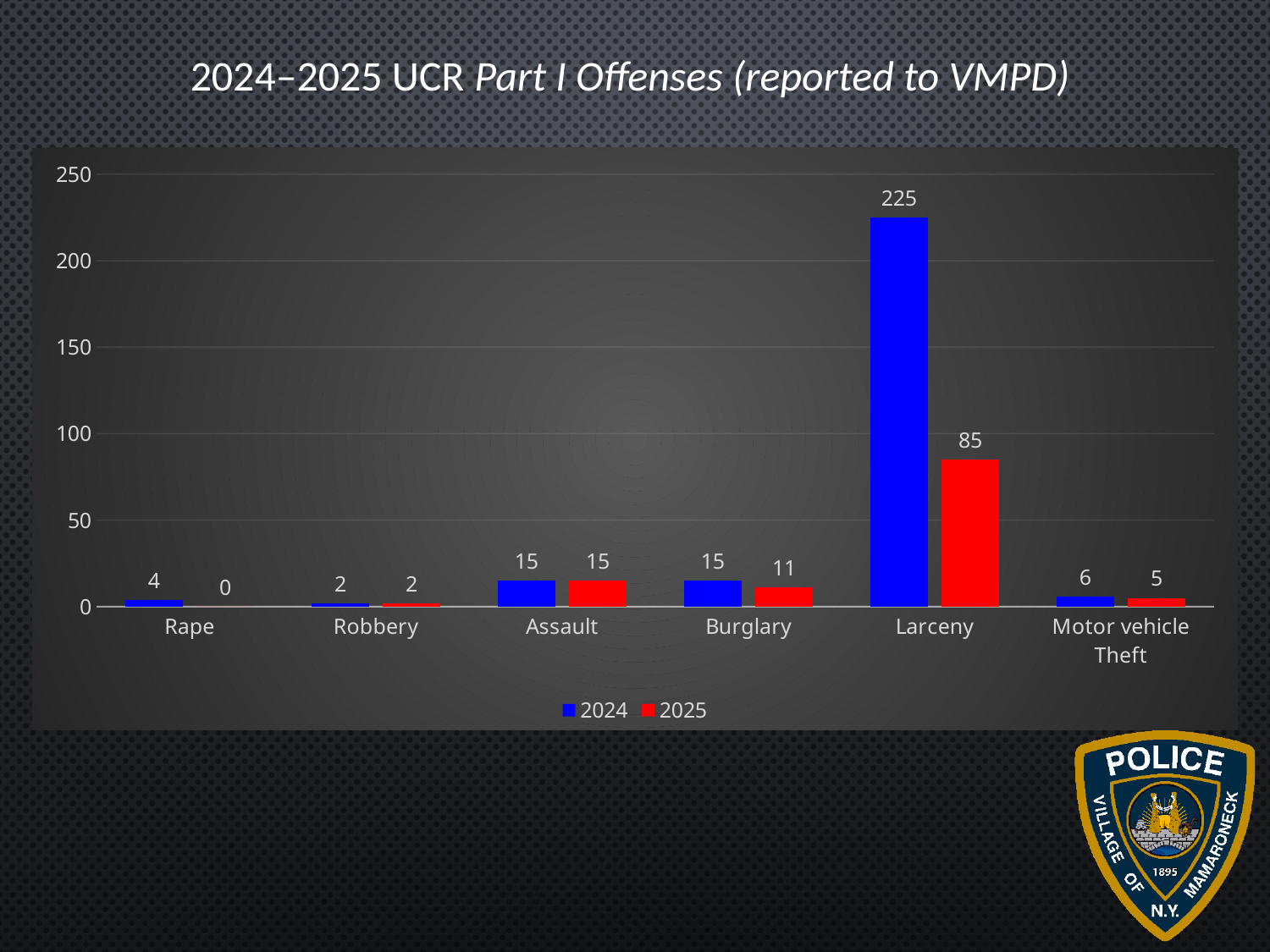
Which is larger for Motor vehicle Theft, the 2024 value or the 2025 value? 2024 How many offense categories are shown on the x axis? 6 What kind of chart is shown on the slide? bar chart Which category has the highest 2025 value? Larceny What is the 2025 value for Rape? 0 What is the difference between the 2024 and 2025 values for Larceny? 140 Is the 2025 value for Larceny greater or less than 100? less Which category has the lowest 2024 value? Robbery What is the 2025 value for Burglary? 11 What is the 2024 value for Larceny? 225 How many series does the legend list? 2 What colour represents the 2025 series? red